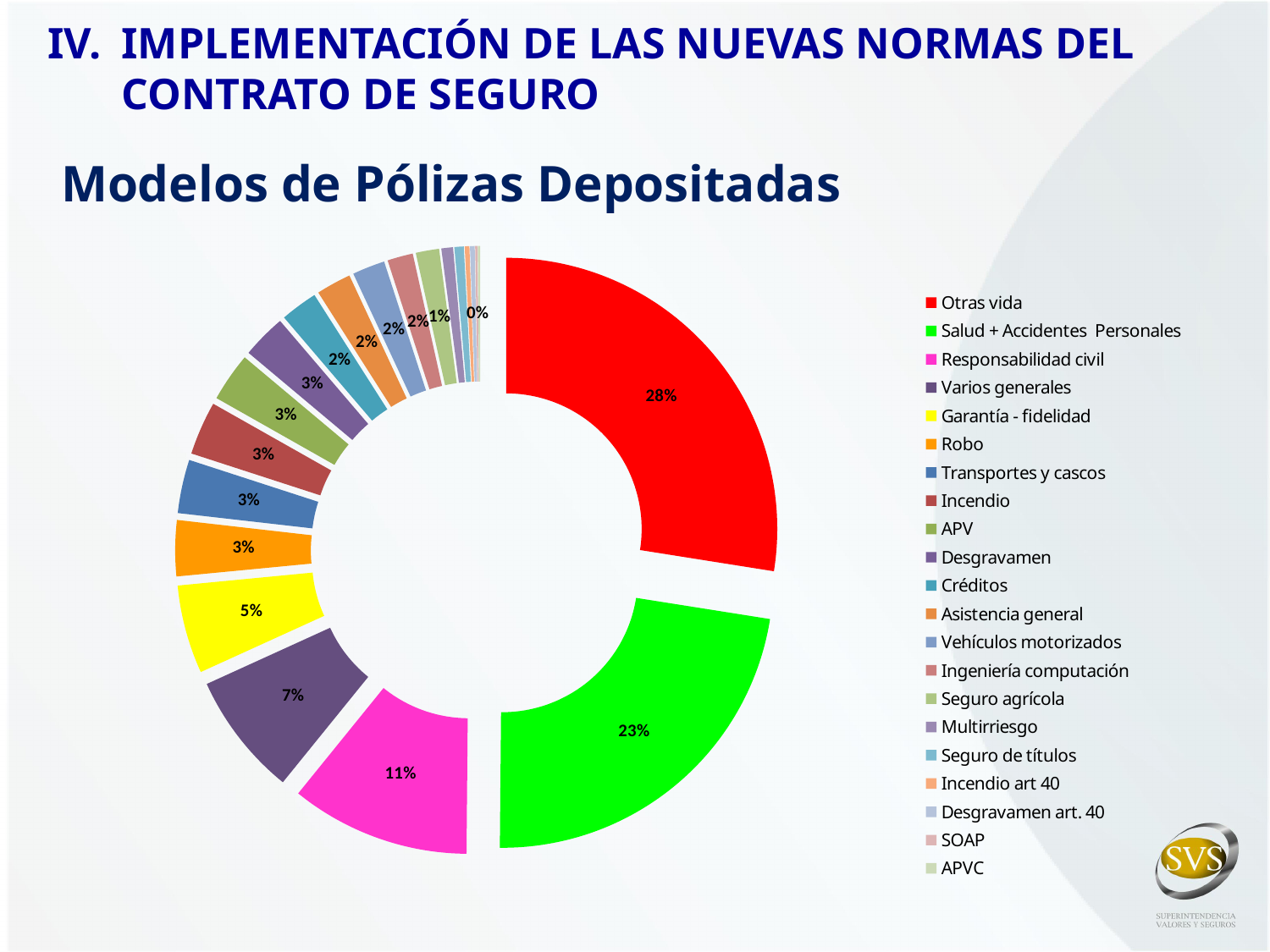
What percentage is shown for Responsabilidad civil? 11% What percentage is shown for Varios generales? 7% What is the difference in percentage points between Otras vida and Salud + Accidentes Personales? 5 percentage points What kind of chart is shown on the slide? doughnut (pie) chart How many categories does the legend list? 21 What percentage is shown for Salud + Accidentes Personales? 23% What percentage is shown for Robo? 3% Which category has the largest share of the chart? Otras vida Which is larger, the share for Responsabilidad civil or the share for Varios generales? Responsabilidad civil What share of the chart does Otras vida represent? 28% What is the title of the chart? Modelos de Pólizas Depositadas What percentage is shown for Garantía - fidelidad? 5%